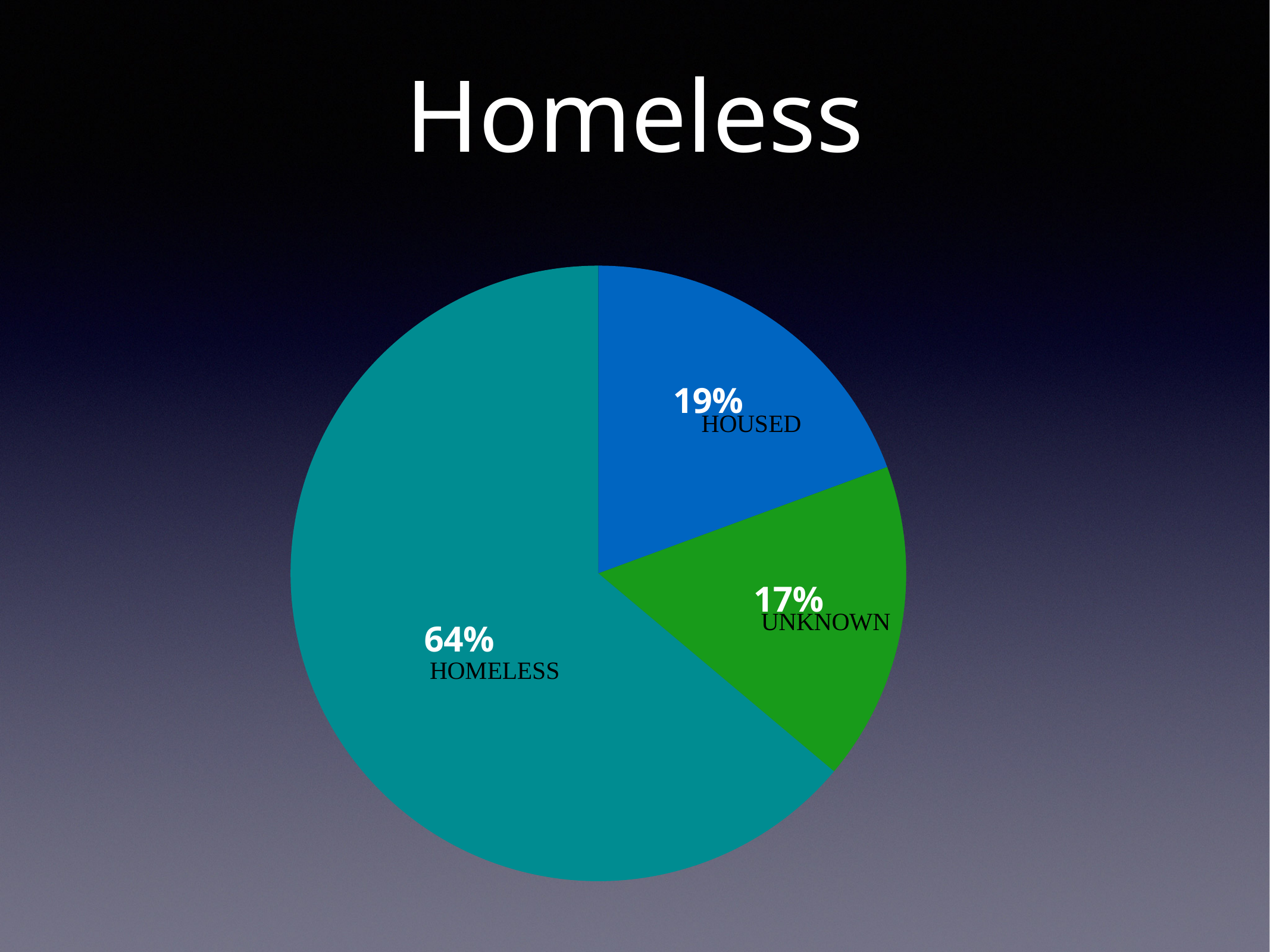
What is the difference in percentage points between the HOMELESS slice and the HOUSED slice? 45 Which slice of the pie is the largest? HOMELESS What is the difference in percentage points between the HOUSED slice and the UNKNOWN slice? 2 What colour is the HOMELESS slice of the pie? teal What percentage of the pie is labelled HOMELESS? 64% Which slice of the pie is the smallest? UNKNOWN What is the title of the slide containing the pie chart? Homeless How many slices does the pie chart have? 3 What percentage of the pie is labelled UNKNOWN? 17% What kind of chart is shown on the slide? pie chart What percentage of the pie is labelled HOUSED? 19% Which is larger, the HOUSED slice or the UNKNOWN slice? HOUSED